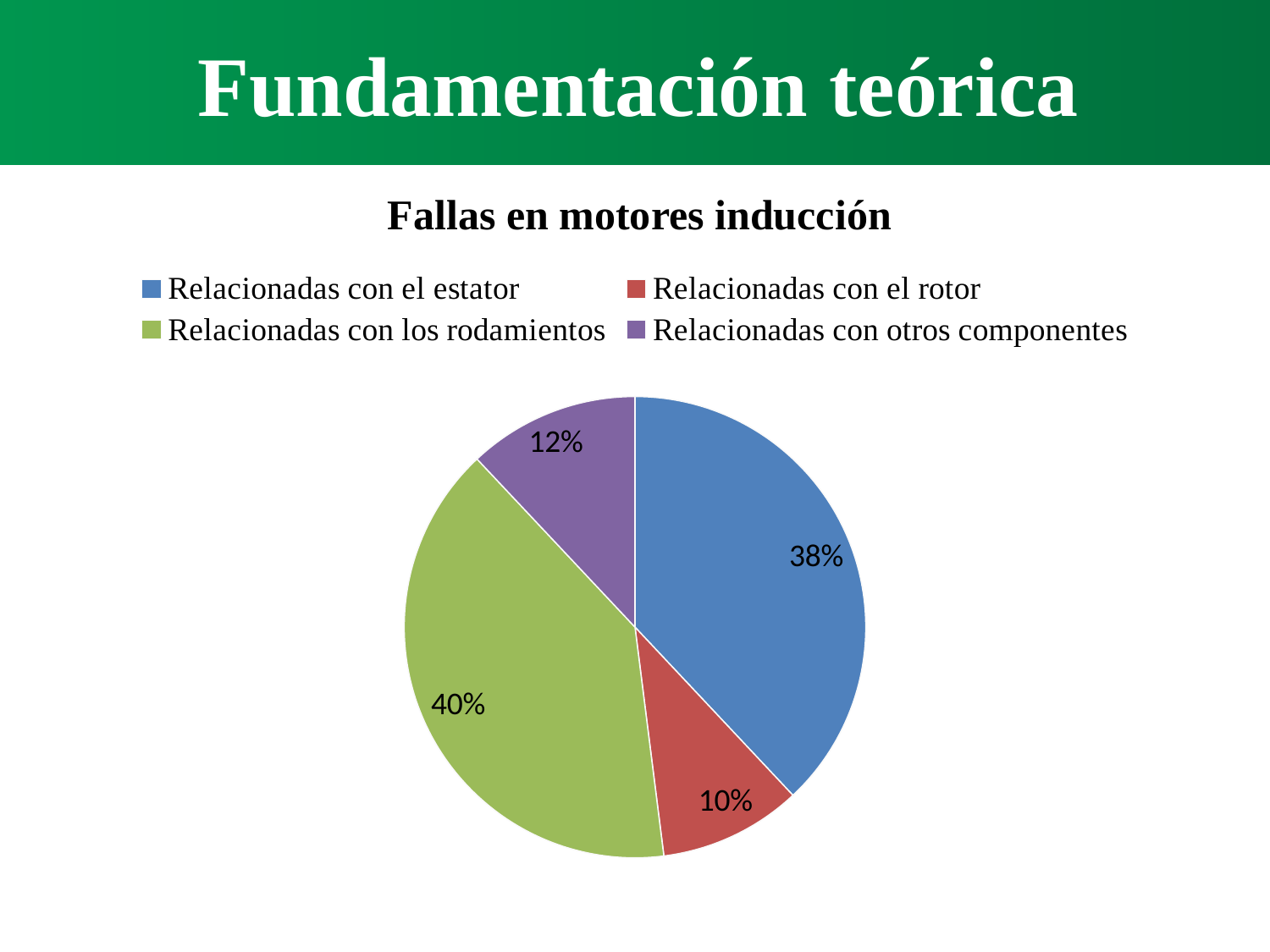
Which category has the largest slice of the pie? Relacionadas con los rodamientos What colour is the slice for 'Relacionadas con los rodamientos'? green What type of chart is shown on the slide? pie chart Which category has the smallest slice of the pie? Relacionadas con el rotor Which is larger: the slice for 'Relacionadas con otros componentes' or the slice for 'Relacionadas con el rotor'? Relacionadas con otros componentes What share of the pie is labelled for 'Relacionadas con el estator'? 38% What is the title of the chart? Fallas en motores inducción What is the difference in percentage points between 'Relacionadas con el estator' and 'Relacionadas con el rotor'? 28 What share of the pie is labelled for 'Relacionadas con otros componentes'? 12% What share of the pie is labelled for 'Relacionadas con los rodamientos'? 40% What share of the pie is labelled for 'Relacionadas con el rotor'? 10% How many slices does the pie chart have? 4